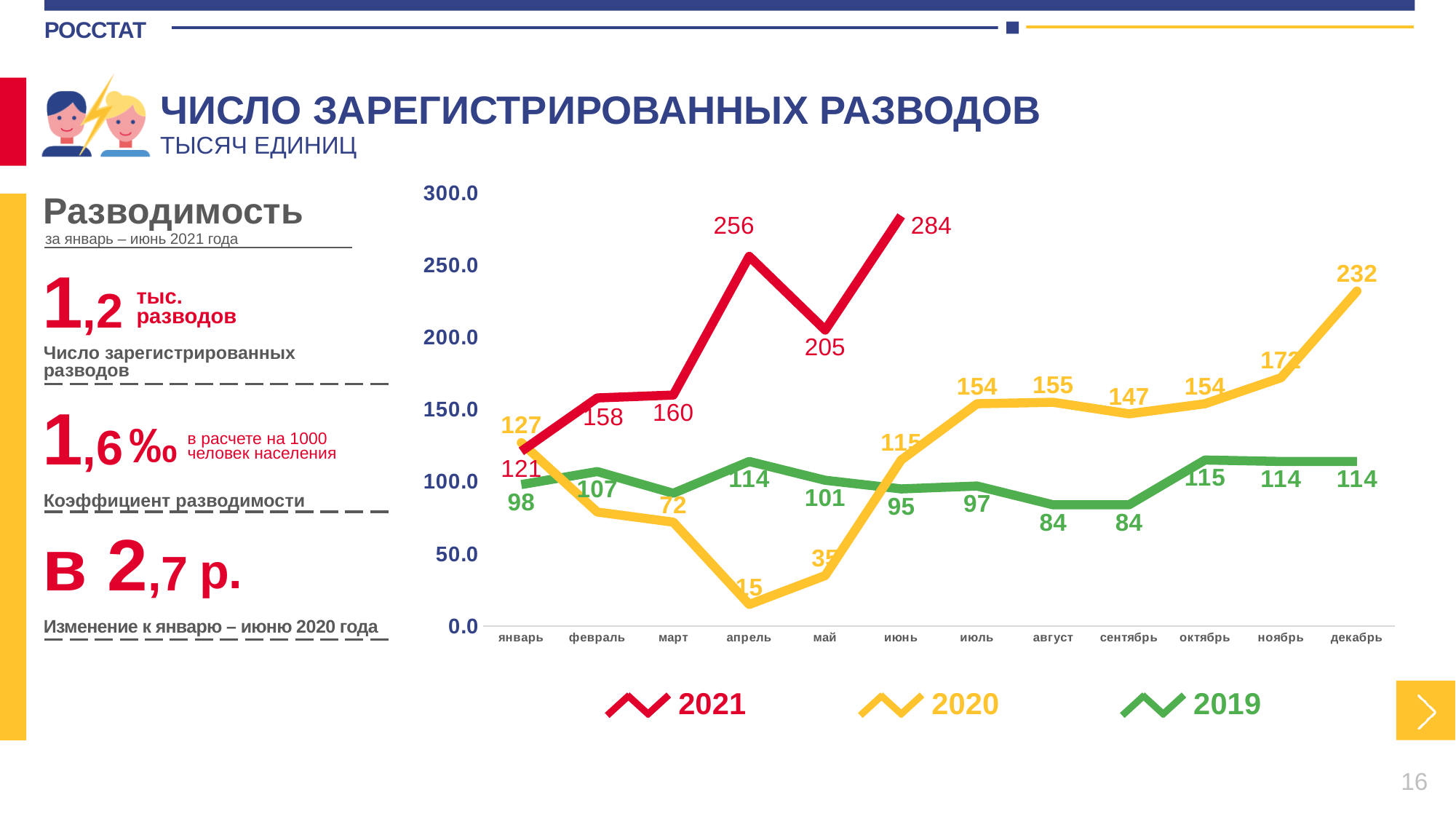
What is the value for 2019 in август? 84 In which month does the 2020 series reach its lowest value? апрель How many months are shown on the x axis? 12 What is the value for 2020 in декабрь? 232 What kind of chart is shown on the slide? line chart Is the value for 2020 in февраль greater or less than 100? less What is the difference between the 2021 values for апрель and май? 51 How many series does the legend list? 3 What is the value for 2021 in июнь? 284 Which series has the larger value in июнь, 2021 or 2020? 2021 Does the 2021 series rise or fall from январь to апрель? rise In which month does the 2021 series reach its highest value? июнь